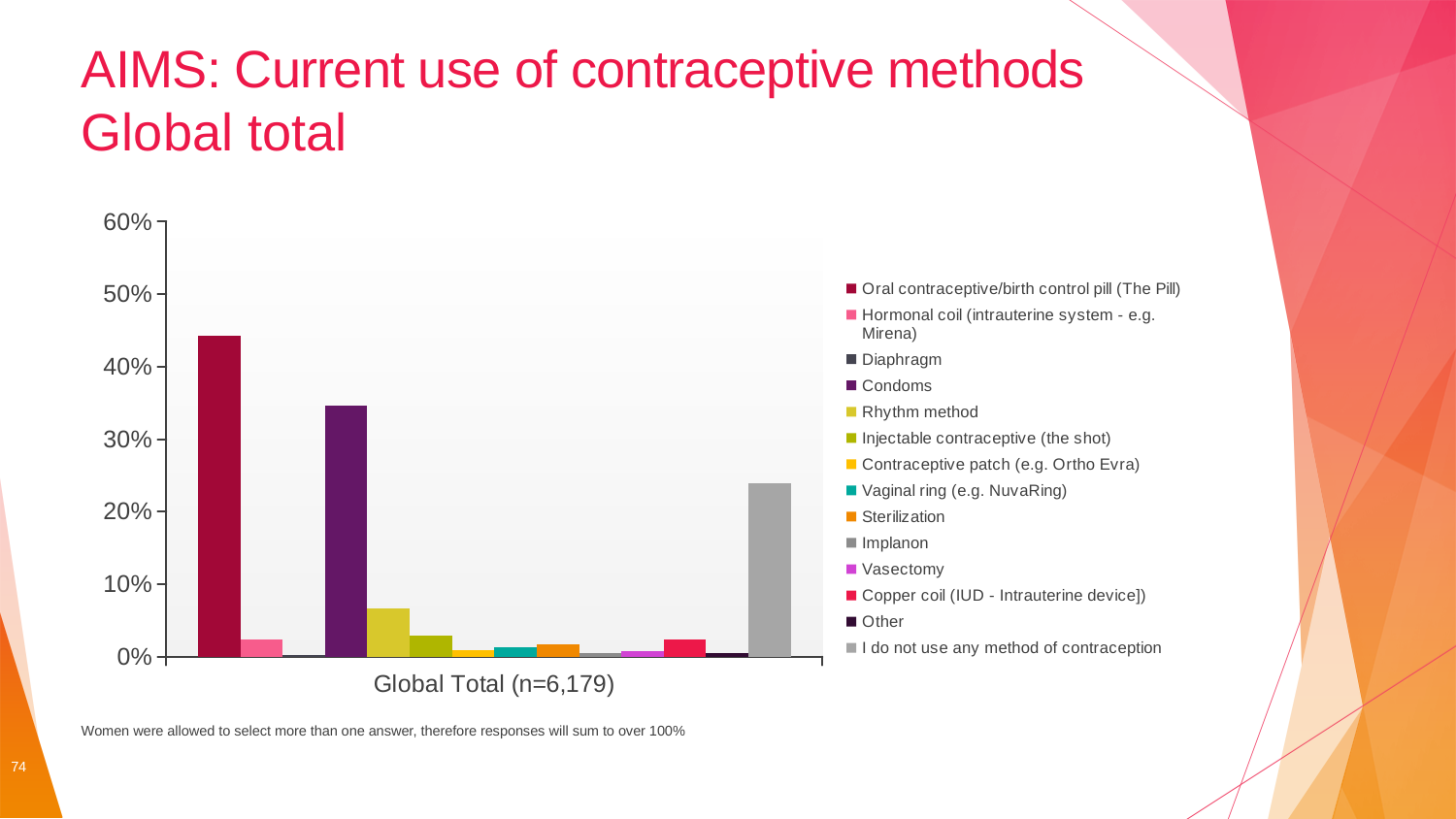
Which is larger, the value for Condoms or the value for 'I do not use any method of contraception'? Condoms Which contraceptive method has the highest bar? Oral contraceptive/birth control pill (The Pill) Is the value for Rhythm method greater or less than 10%? less How many categories are shown on the x axis? 1 Is the value for Condoms greater or less than 40%? less Which is larger, the value for Rhythm method or the value for Injectable contraceptive (the shot)? Rhythm method What kind of chart is shown on the slide? bar chart Is the value for Condoms greater or less than 30%? greater What is the label on the x axis of the chart? Global Total (n=6,179) How many series does the legend list? 14